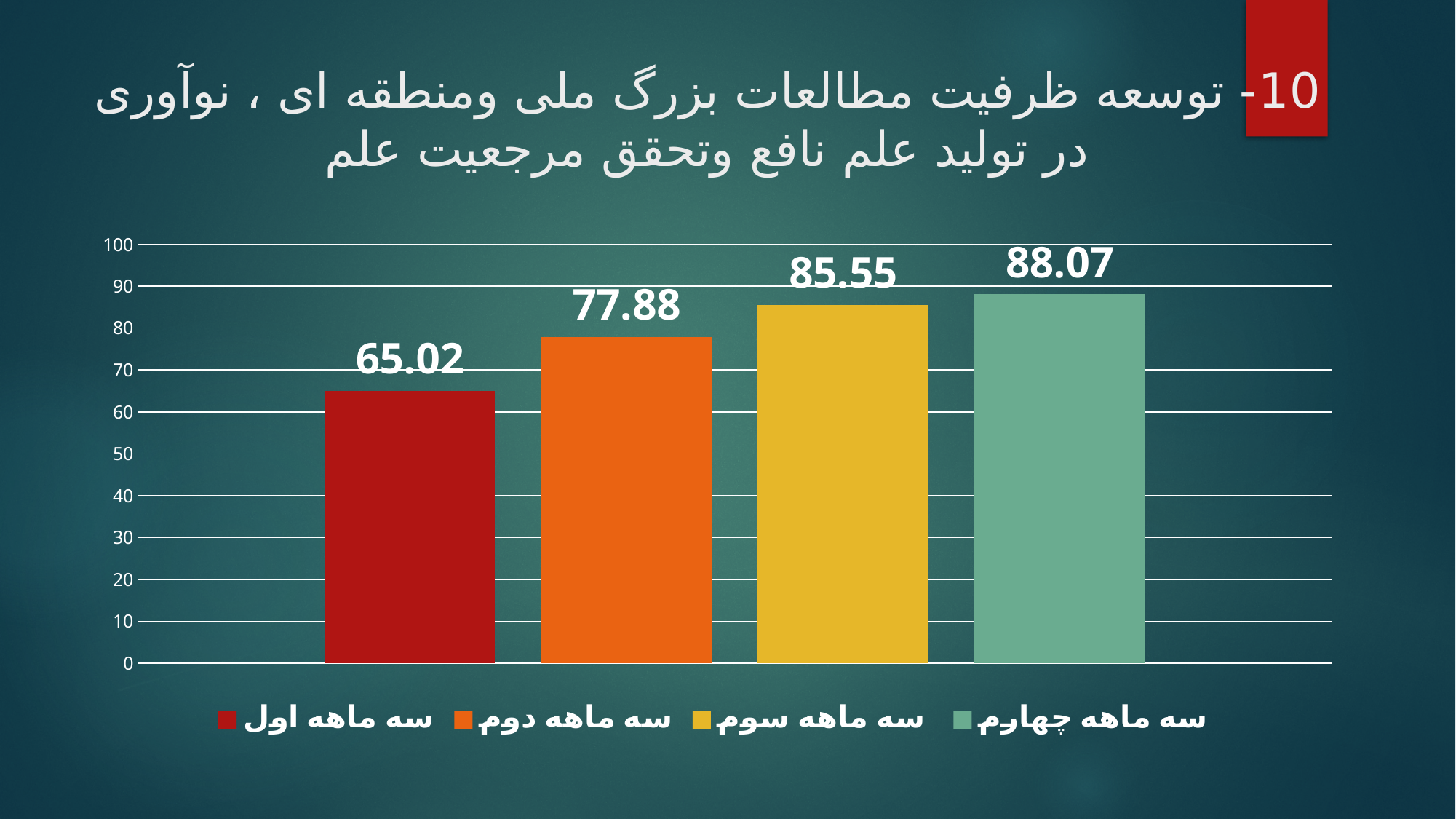
Which is larger, the value for سه ماهه سوم or سه ماهه دوم? سه ماهه سوم Which quarter has the lowest value? سه ماهه اول What type of chart is shown on the slide? bar chart How many bars are plotted in the chart? 4 What is the difference between the values for سه ماهه چهارم and سه ماهه اول? 23.05 What is the value for سه ماهه دوم (second quarter)? 77.88 What is the value for سه ماهه چهارم (fourth quarter)? 88.07 Do the values rise or fall from left to right across the bars? rise What is the value for سه ماهه سوم (third quarter)? 85.55 What is the value for سه ماهه اول (first quarter)? 65.02 What is the difference between the values for سه ماهه دوم and سه ماهه اول? 12.86 Which quarter has the highest value? سه ماهه چهارم